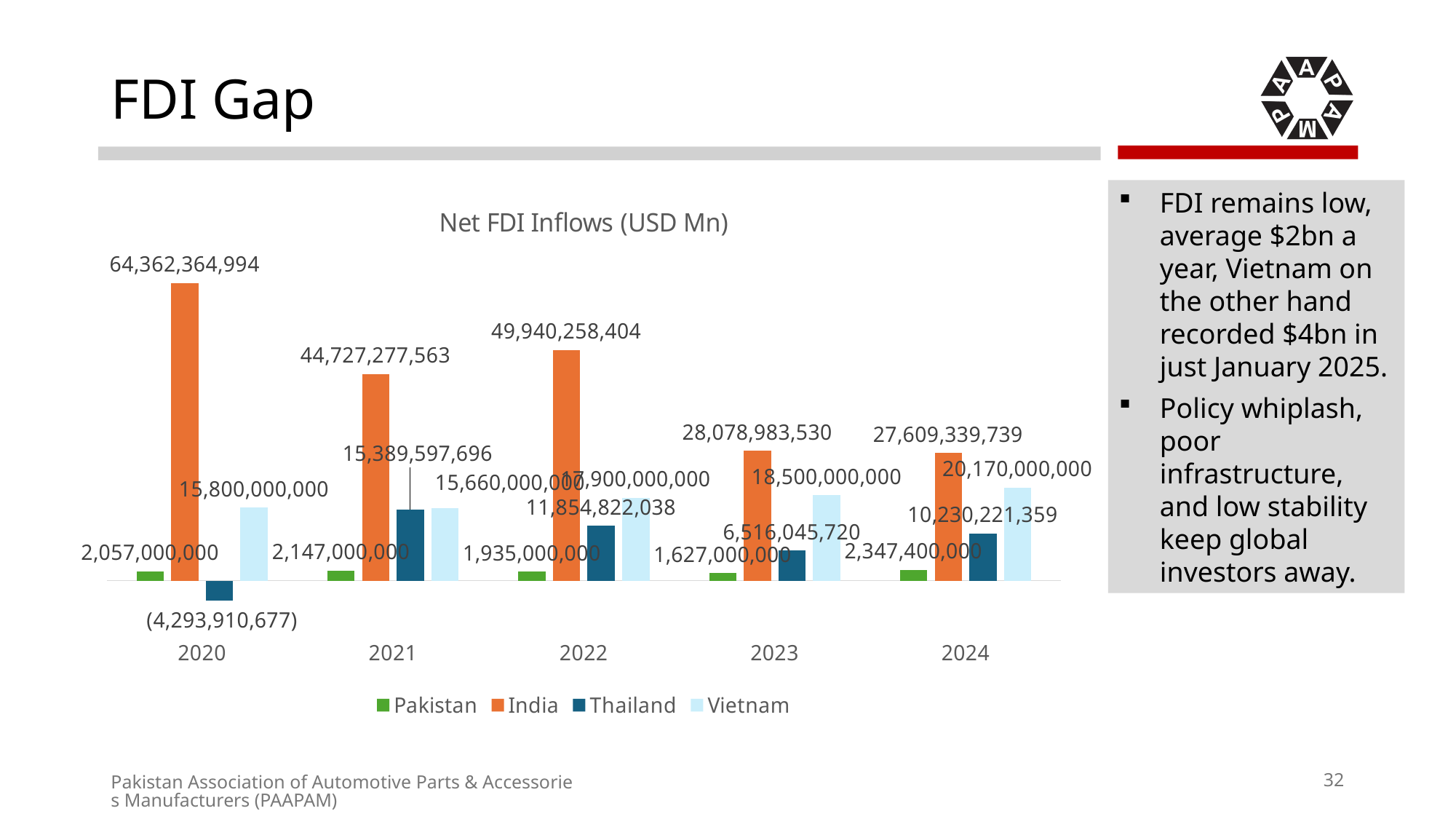
What type of chart is shown on the slide? Bar chart What is the value for Vietnam in 2024? 20,170,000,000 What is the difference between the value for Pakistan in 2024 and in 2023? 720,400,000 How many years are shown on the x axis? 5 What is the value for Pakistan in 2023? 1,627,000,000 In which year is the value for India the highest? 2020 What is the title of the chart? Net FDI Inflows (USD Mn) What is the value for India in 2020? 64,362,364,994 What is the value for Thailand in 2020? (4,293,910,677) Which is larger in 2021, the value for Thailand or the value for Vietnam? Vietnam In which year is the value for Pakistan the lowest? 2023 How many series does the legend list? 4